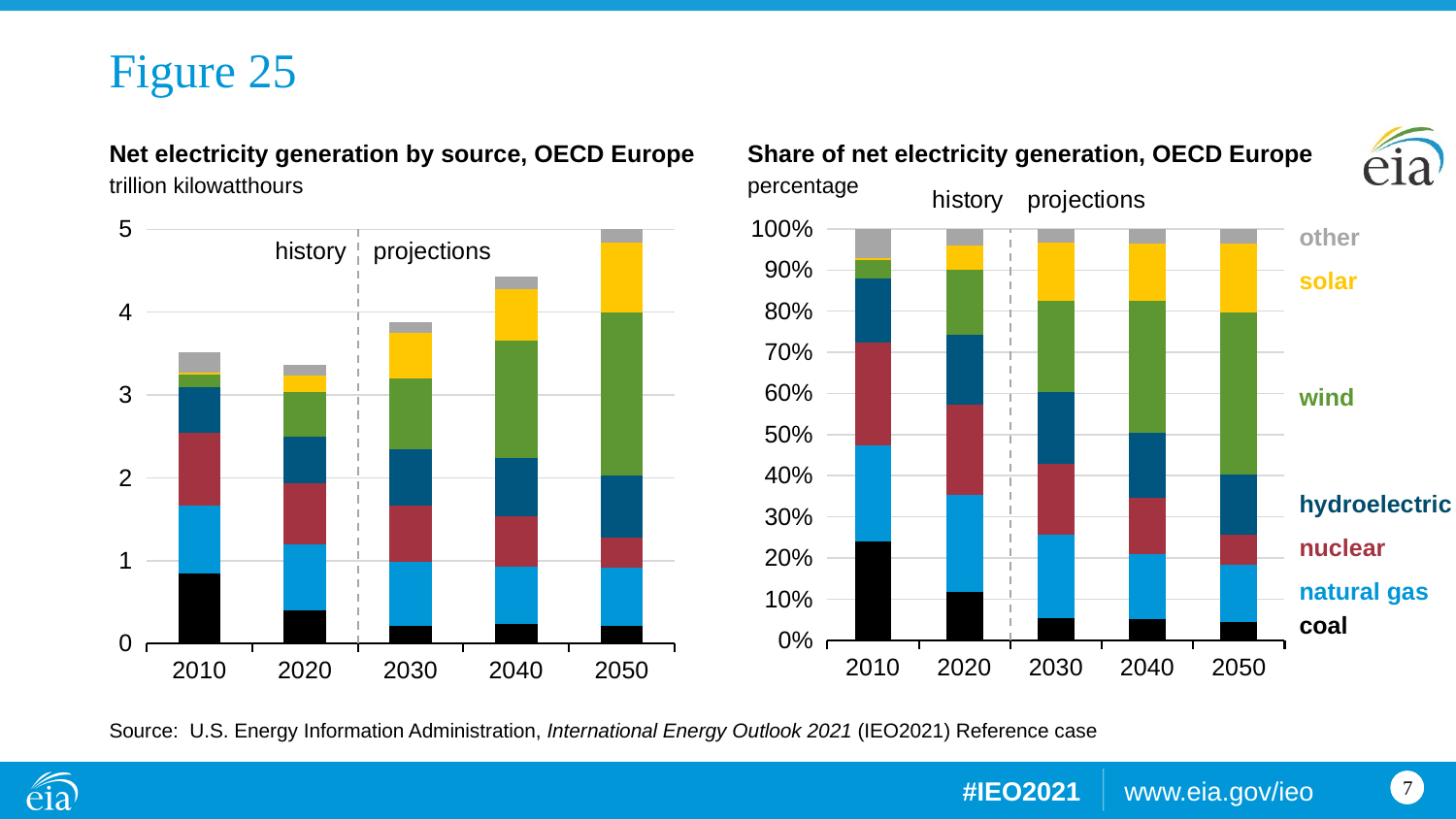
In the right chart, 'Share of net electricity generation, OECD Europe', is the coal share in 2050 greater or less than 10%? less How many years are shown on the x axis of the right chart, 'Share of net electricity generation, OECD Europe'? 5 What unit is used on the y axis of the left chart, 'Net electricity generation by source, OECD Europe'? trillion kilowatthours How many sources does the legend of the right chart, 'Share of net electricity generation, OECD Europe', list? 7 In the right chart, 'Share of net electricity generation, OECD Europe', does the wind share rise or fall from 2010 to 2050? rise In the right chart, 'Share of net electricity generation, OECD Europe', is the coal share in 2010 greater or less than 20%? greater In the left chart, 'Net electricity generation by source, OECD Europe', is the total generation in 2050 greater or less than 4 trillion kilowatthours? greater What kind of chart is the left chart, 'Net electricity generation by source, OECD Europe'? stacked bar chart In the right chart, 'Share of net electricity generation, OECD Europe', which source is shown in yellow? solar In the right chart, 'Share of net electricity generation, OECD Europe', is the natural gas share larger in 2010 or in 2050? 2010 In the left chart, 'Net electricity generation by source, OECD Europe', which year has the tallest total bar? 2050